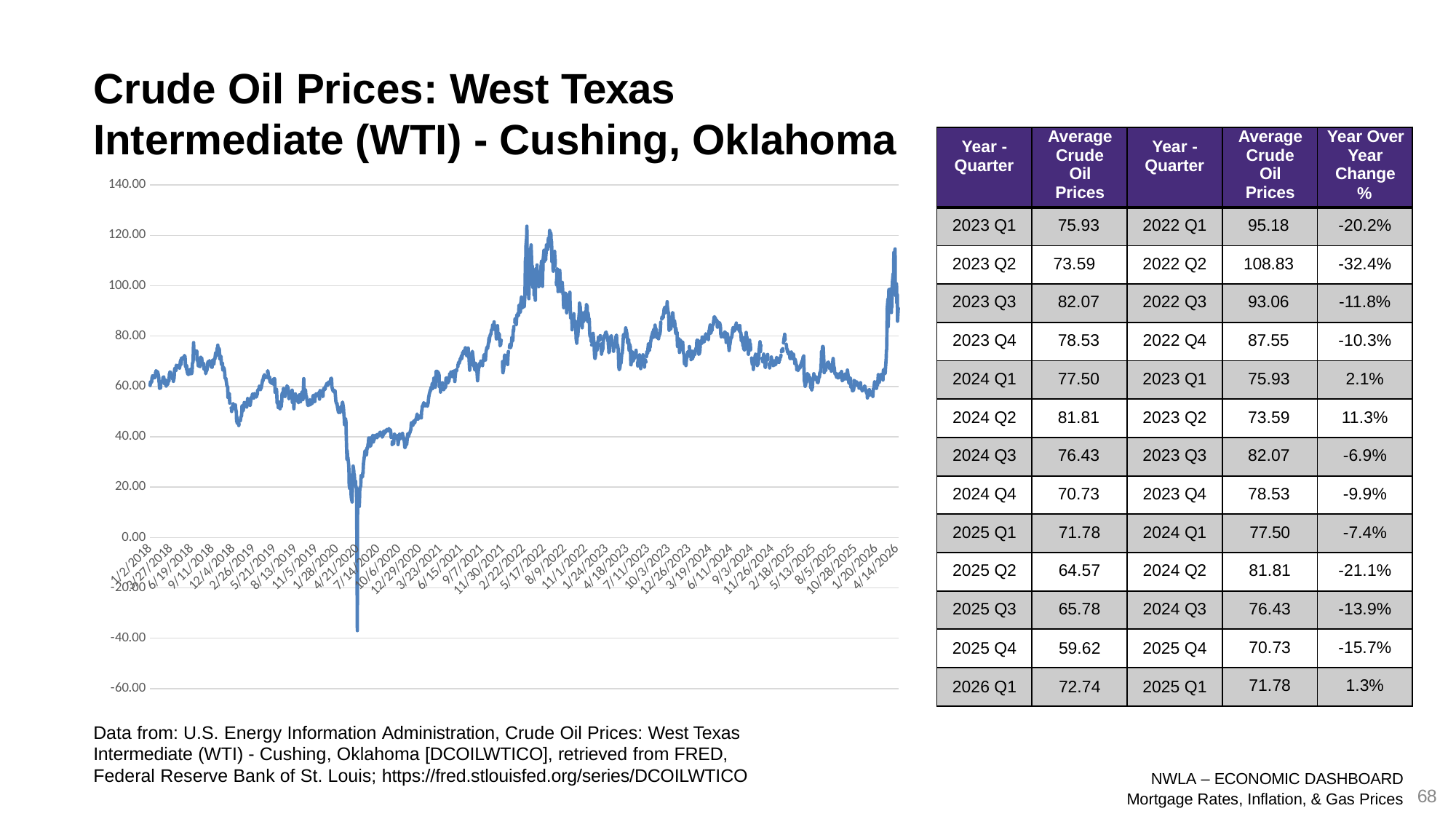
In which year does the line reach its highest point? 2022 Does the line generally rise or fall between 4/21/2020 and 5/17/2022? rise Is the value at the start of the series (1/2/2018) greater or less than 40.00? greater What kind of chart is shown on the slide? line chart Is the value around 1/20/2026 greater or less than 80.00? less In which year does the line reach its lowest point? 2020 Is the lowest point of the line greater or less than 0.00? less What is the highest value shown on the chart's vertical axis? 140.00 Which is larger, the value at 5/17/2022 or the value at 1/2/2018? 5/17/2022 What is the title of the chart on the slide? Crude Oil Prices: West Texas Intermediate (WTI) - Cushing, Oklahoma